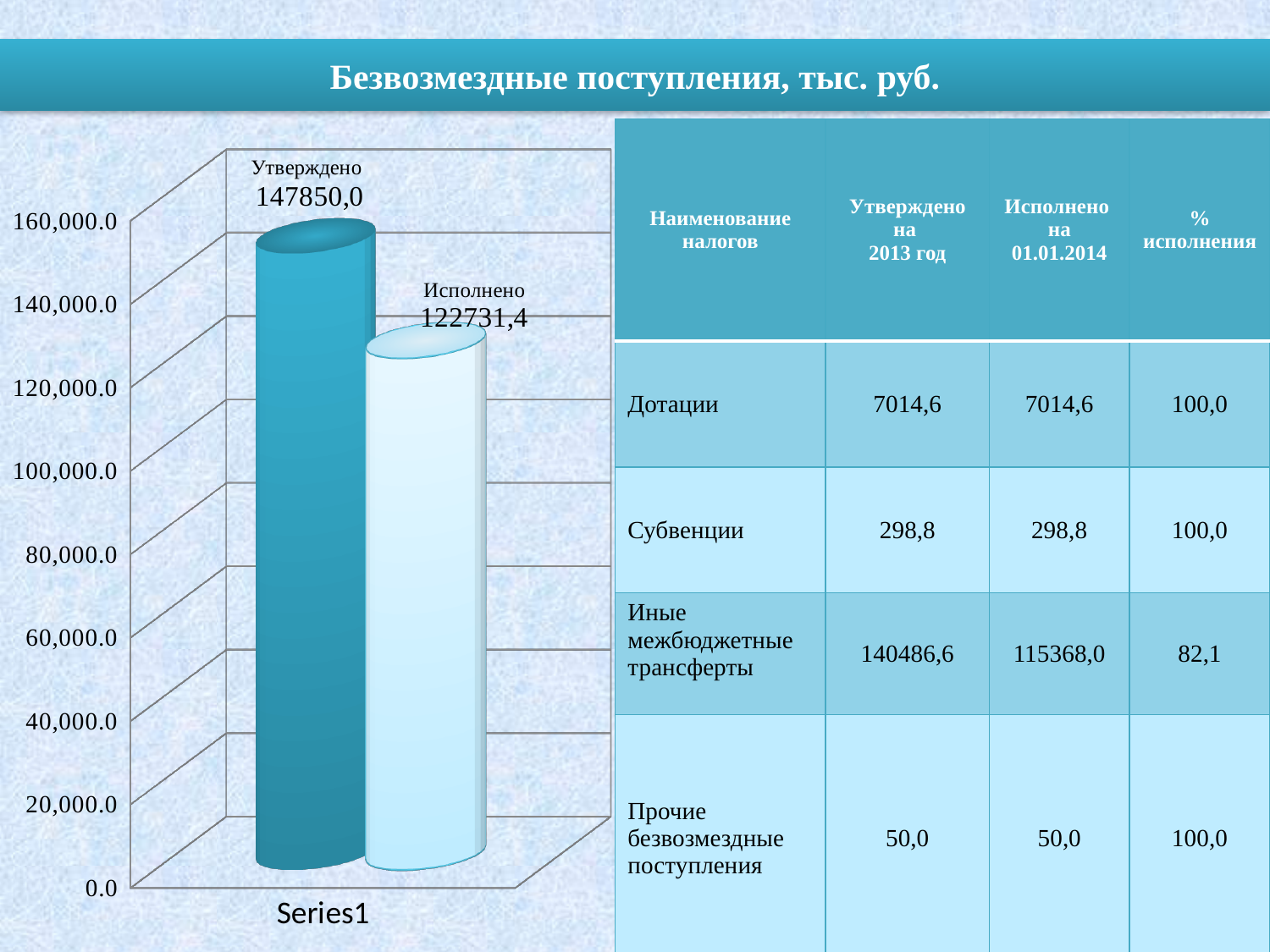
What is the difference between the Утверждено and Исполнено values on the chart? 25118,6 Which bar on the chart is higher, Утверждено or Исполнено? Утверждено What is the highest value shown on the chart's vertical axis? 160,000.0 Is the value for Утверждено greater or less than 140,000.0? greater Is the value for Исполнено greater or less than 140,000.0? less Which bar on the chart is the lowest? Исполнено What is the value of the Исполнено bar on the chart? 122731,4 How many bars are plotted on the chart? 2 What kind of chart is shown on the slide? bar chart Is the value for Утверждено greater or less than 160,000.0? less What is the title of the slide above the chart? Безвозмездные поступления, тыс. руб. What is the value of the Утверждено bar on the chart? 147850,0